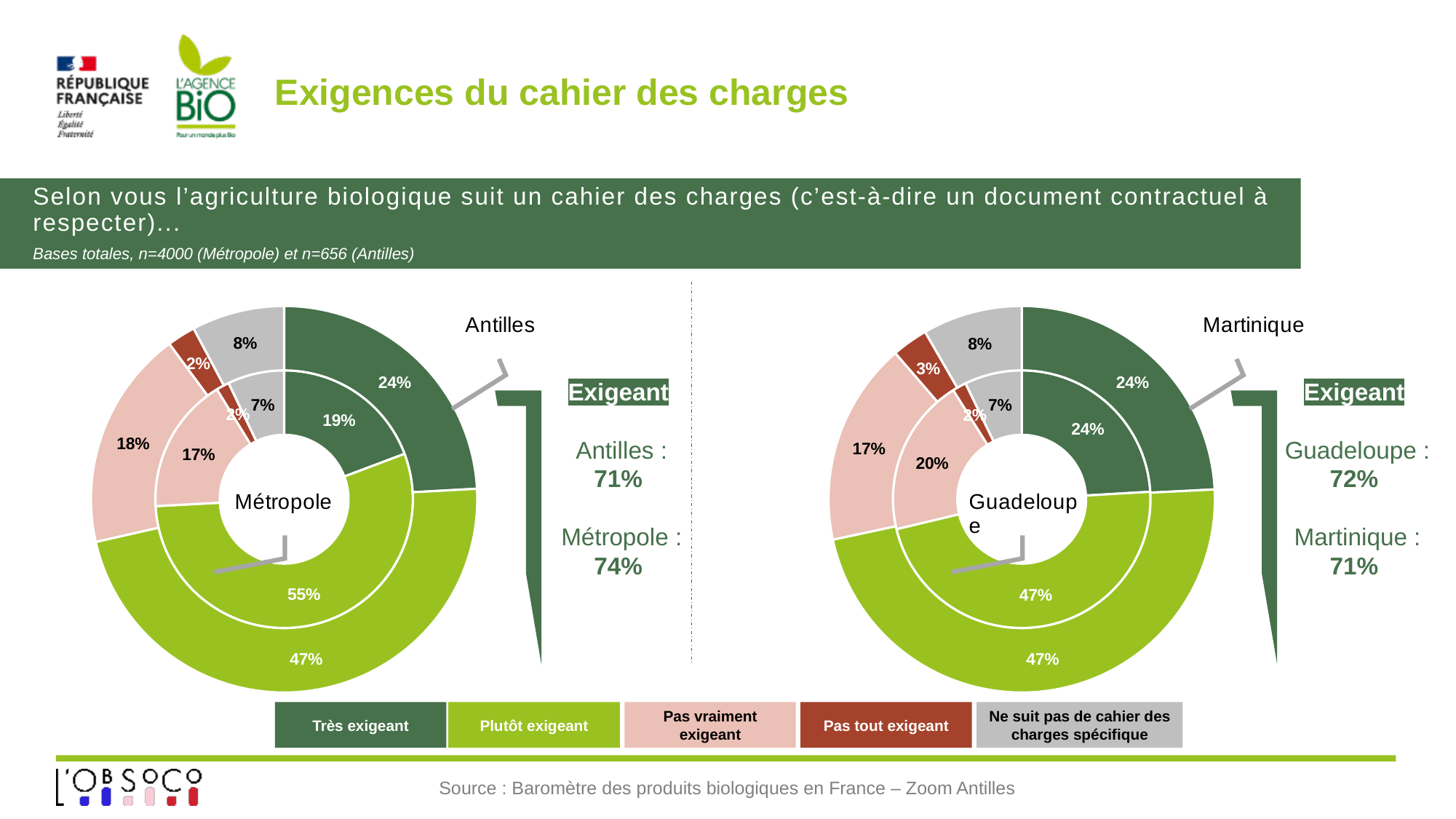
In the right chart, which is larger: the "Pas vraiment exigeant" share for Guadeloupe or for Martinique? Guadeloupe In the right chart, what is the combined "Exigeant" share for Guadeloupe, as printed on the slide? 72% In the right chart, what share of Martinique respondents answered "Pas tout exigeant"? 3% How many response categories does the legend list? 5 In the left chart, what share of Métropole respondents answered "Plutôt exigeant"? 55% In the left chart, which response category has the largest share for Antilles? Plutôt exigeant What type of chart is used on this slide? Doughnut chart In the right chart, what share of Guadeloupe respondents answered "Pas vraiment exigeant"? 20% In the left chart, what is the combined "Exigeant" share (Très + Plutôt exigeant) for Antilles, as printed on the slide? 71% In the left chart, what is the difference between the "Plutôt exigeant" shares of Métropole and Antilles? 8 percentage points In the left chart, which response category has the smallest share for Métropole? Pas tout exigeant In the left chart, what share of Antilles respondents answered "Très exigeant"? 24%